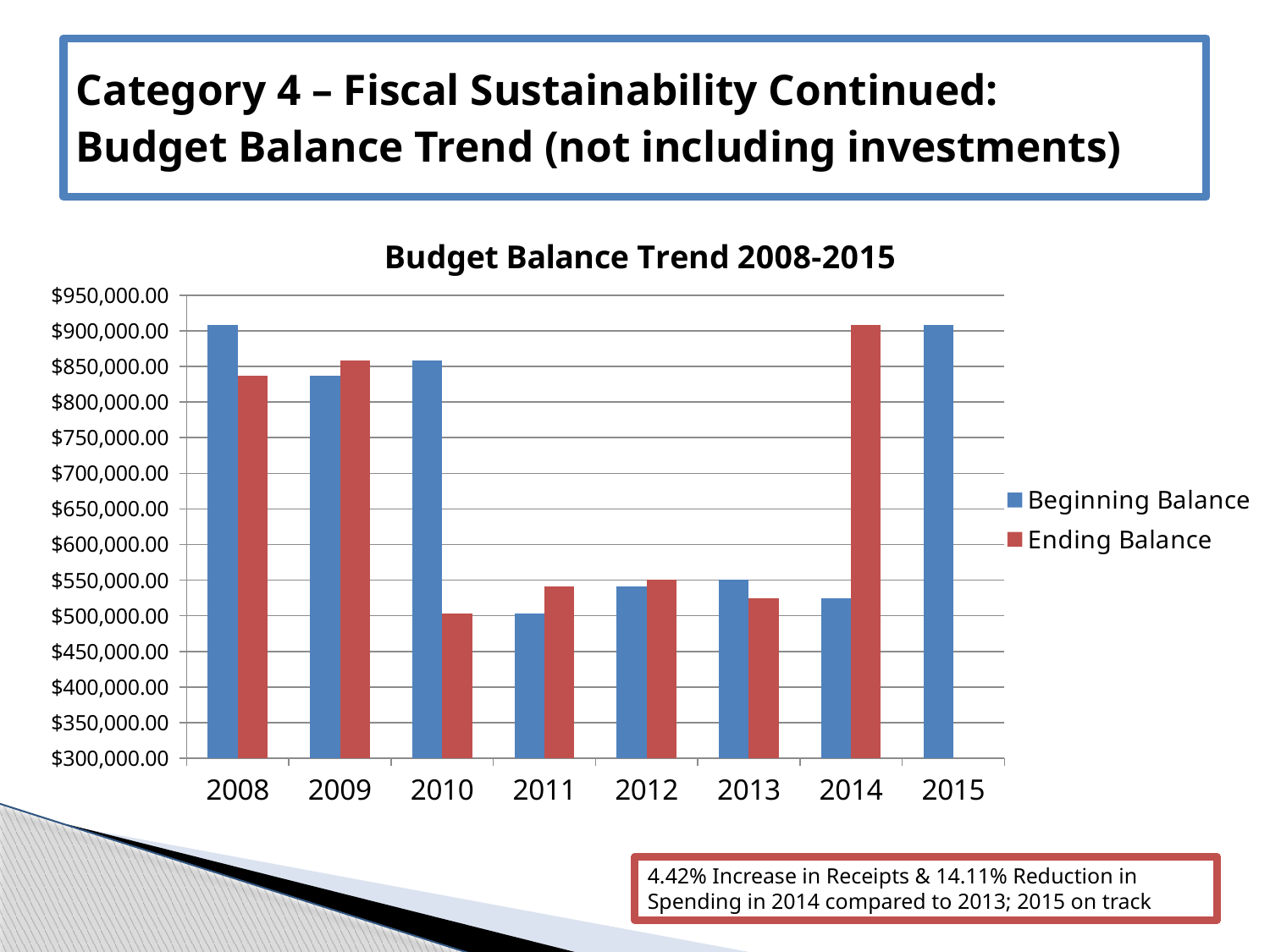
What kind of chart is shown on the slide? Bar chart Which year has the highest Ending Balance? 2014 In 2014, which is larger, the Beginning Balance or the Ending Balance? Ending Balance Which year has the lowest Beginning Balance? 2011 In 2010, which is larger, the Beginning Balance or the Ending Balance? Beginning Balance How many series does the legend list in the Budget Balance Trend 2008-2015 chart? 2 Which year has the lowest Ending Balance? 2010 Is the Beginning Balance for 2008 greater or less than $900,000.00? greater Is the Ending Balance for 2010 greater or less than $550,000.00? less Does the Beginning Balance rise or fall from 2008 to 2011? Fall Is the Ending Balance for 2014 greater or less than $900,000.00? greater How many years are shown on the x axis of the chart? 8